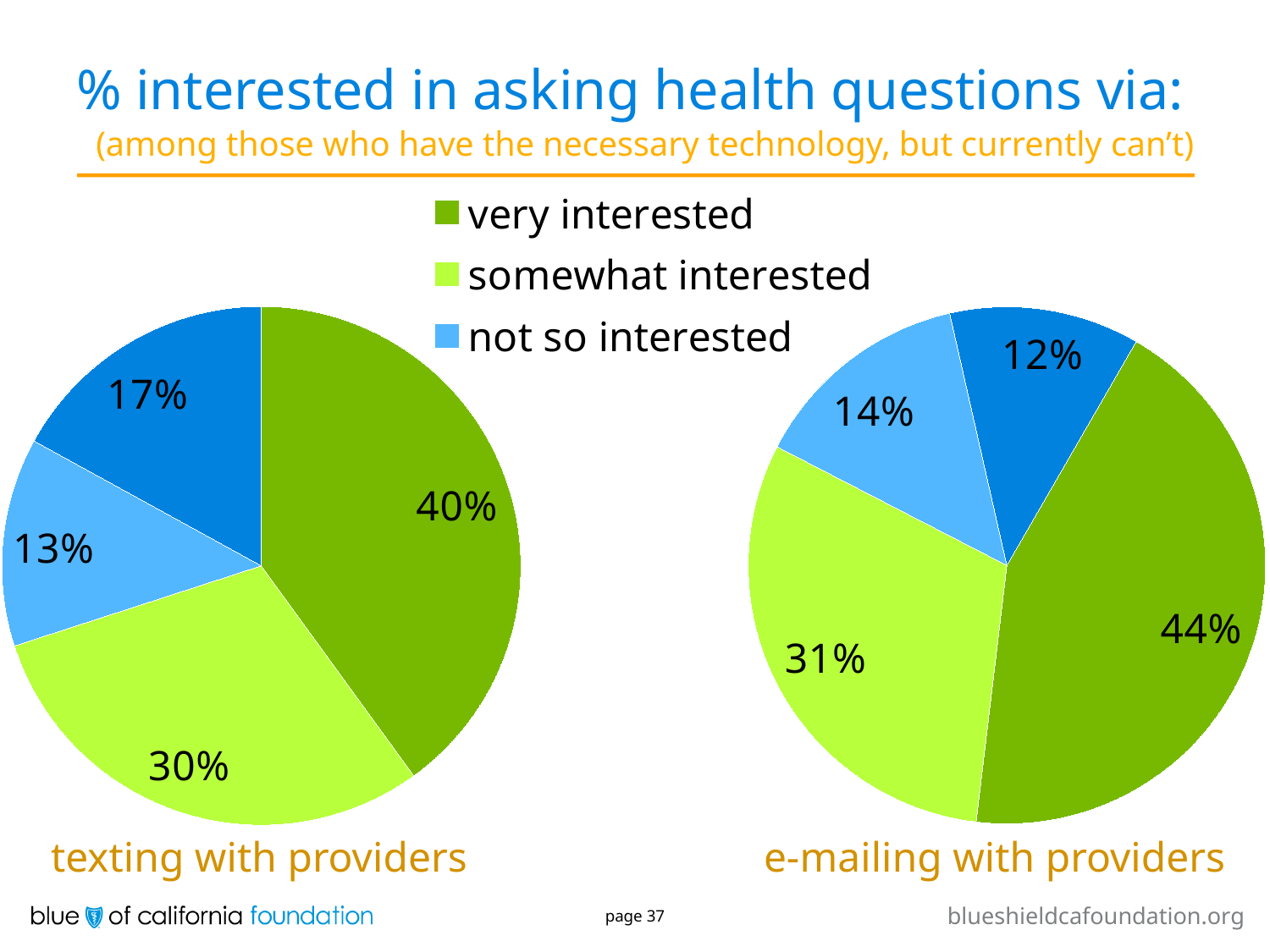
What is the smallest percentage shown in the 'e-mailing with providers' pie chart? 12% In the 'e-mailing with providers' pie chart, what percentage is very interested? 44% In the 'texting with providers' pie chart, which legend category has the largest slice? very interested In the 'e-mailing with providers' pie chart, what percentage is somewhat interested? 31% Is the 'somewhat interested' share larger for texting with providers or for e-mailing with providers? e-mailing with providers How many percentage points higher is the 'very interested' share for e-mailing with providers than for texting with providers? 4 In the 'texting with providers' pie chart, which legend category has the smallest slice? not so interested How many entries does the legend list? 3 How many slices does the 'texting with providers' pie chart have? 4 In the 'texting with providers' pie chart, what percentage is not so interested? 13% What type of chart is used for 'e-mailing with providers'? pie chart In the 'texting with providers' pie chart, what percentage is very interested? 40%